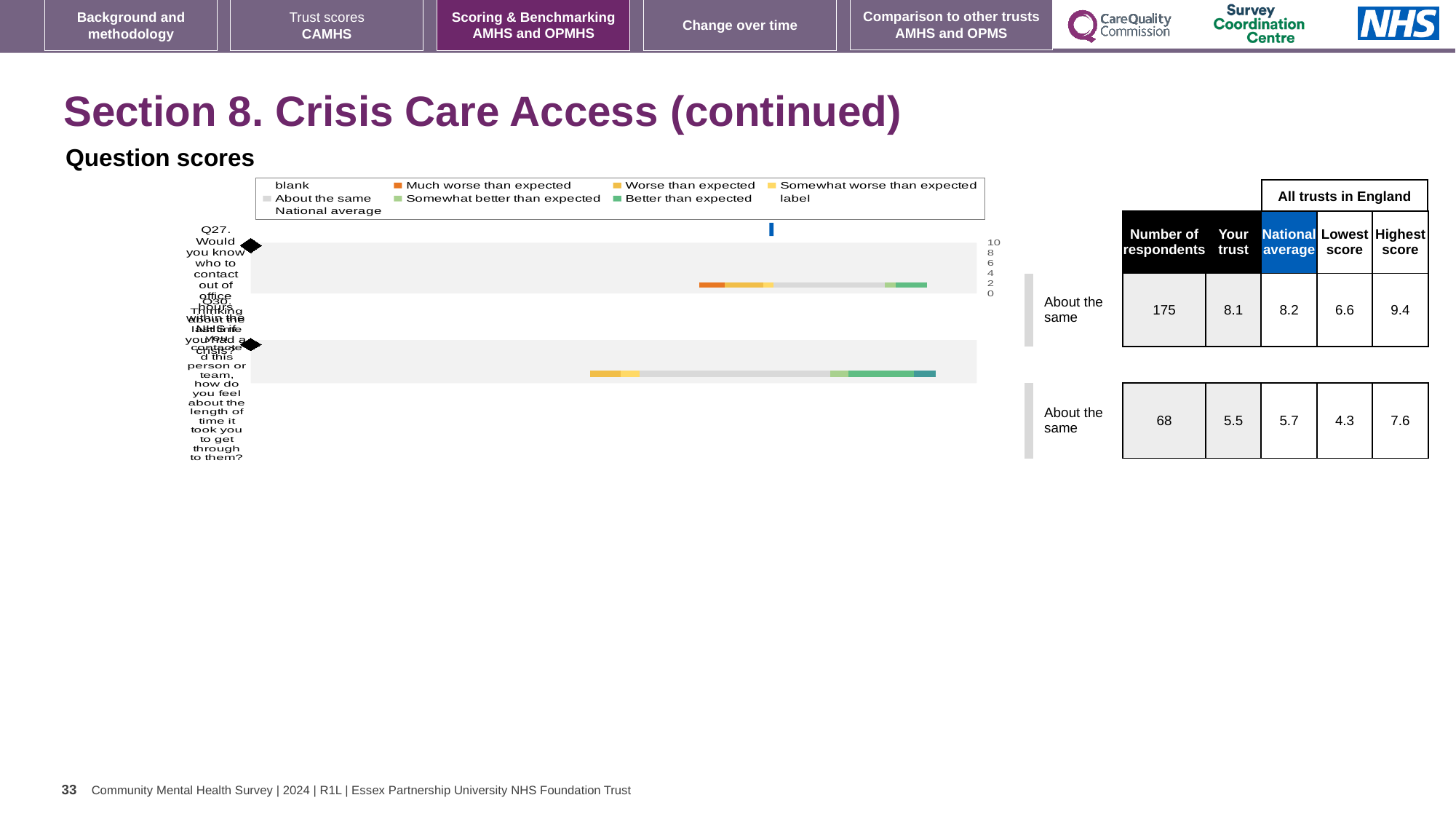
In the table beside the 'Question scores' chart, what is the difference between the highest score and the lowest score for Q27? 2.8 In the table beside the 'Question scores' chart, what is the national average for Q30? 5.7 What kind of chart is shown under the heading 'Question scores'? bar chart How many question bars are plotted in the 'Question scores' chart? 2 In the table beside the 'Question scores' chart, what is the lowest score for Q30? 4.3 What benchmark category label is shown beside each bar in the 'Question scores' chart? About the same In the table beside the 'Question scores' chart, what is the 'Your trust' score for Q27? 8.1 In the table beside the 'Question scores' chart, what is the number of respondents for Q27? 175 In the table beside the 'Question scores' chart, what is the difference between the highest score and the lowest score for Q30? 3.3 In the table beside the 'Question scores' chart, which is larger for Q27: the 'Your trust' score or the national average? National average How many entries does the legend of the 'Question scores' chart list? 9 In the legend of the 'Question scores' chart, what colour represents 'Much worse than expected'? orange